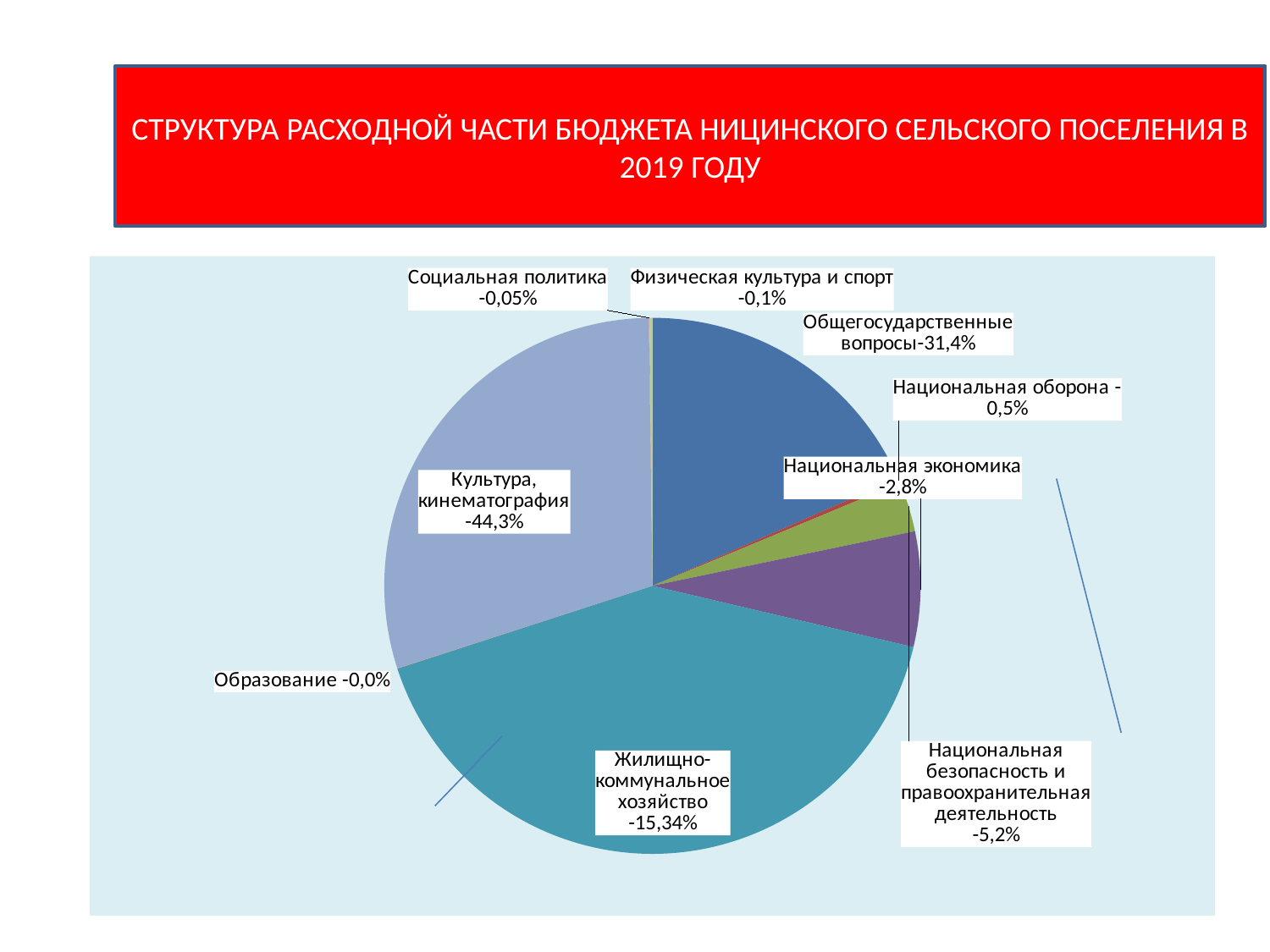
What kind of chart is shown on the slide? pie chart What share of the budget expenditure goes to Общегосударственные вопросы? 31,4% What share of the budget expenditure goes to Культура, кинематография? 44,3% What share is shown for Социальная политика? 0,05% What is the difference between the shares for Культура, кинематография and Общегосударственные вопросы? 12,9% Which category has the smallest share shown on the chart? Образование What share is shown for Национальная безопасность и правоохранительная деятельность? 5,2% How many categories are labelled on the pie chart? 9 What share is shown for Национальная экономика? 2,8% What share of the budget expenditure goes to Жилищно-коммунальное хозяйство? 15,34%